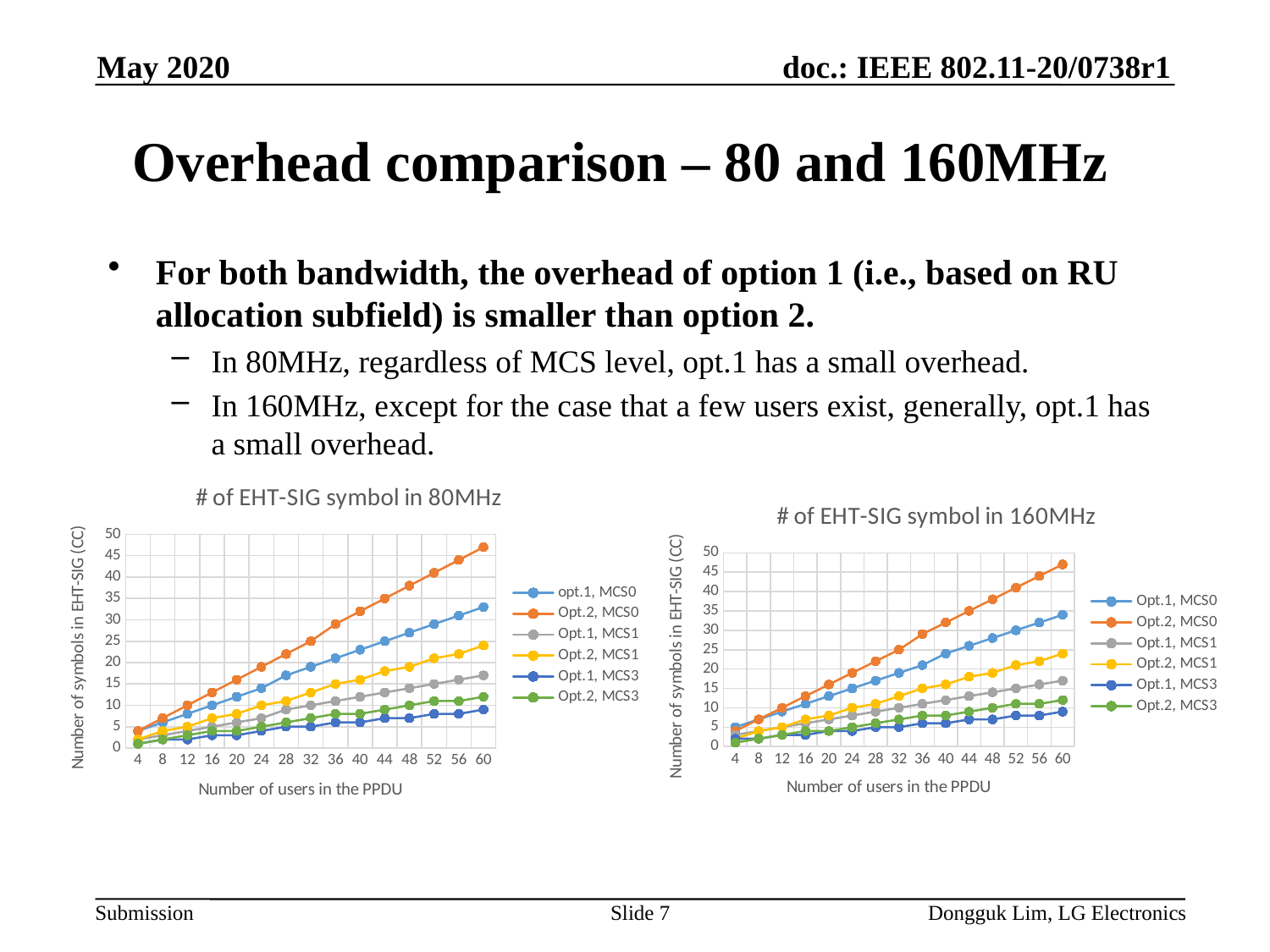
In the '# of EHT-SIG symbol in 80MHz' chart, which series has the highest value at 60 users? Opt.2, MCS0 What type of chart is the '# of EHT-SIG symbol in 80MHz' chart? line chart In the '# of EHT-SIG symbol in 160MHz' chart, at 60 users, which is larger: Opt.2, MCS1 or Opt.1, MCS1? Opt.2, MCS1 What is the y-axis label of the '# of EHT-SIG symbol in 160MHz' chart? Number of symbols in EHT-SIG (CC) In the '# of EHT-SIG symbol in 80MHz' chart, is the value of Opt.2, MCS0 at 60 users greater or less than 40? greater What is the x-axis label of the '# of EHT-SIG symbol in 80MHz' chart? Number of users in the PPDU In the '# of EHT-SIG symbol in 80MHz' chart, is the value of opt.1, MCS0 at 60 users greater or less than 30? greater In the '# of EHT-SIG symbol in 160MHz' chart, which series has the lowest value at 60 users? Opt.1, MCS3 In the '# of EHT-SIG symbol in 80MHz' chart, do the values of Opt.2, MCS0 rise or fall as the number of users increases? rise How many series does the legend of the '# of EHT-SIG symbol in 160MHz' chart list? 6 In the '# of EHT-SIG symbol in 80MHz' chart, how many user-count points are shown along the x axis? 15